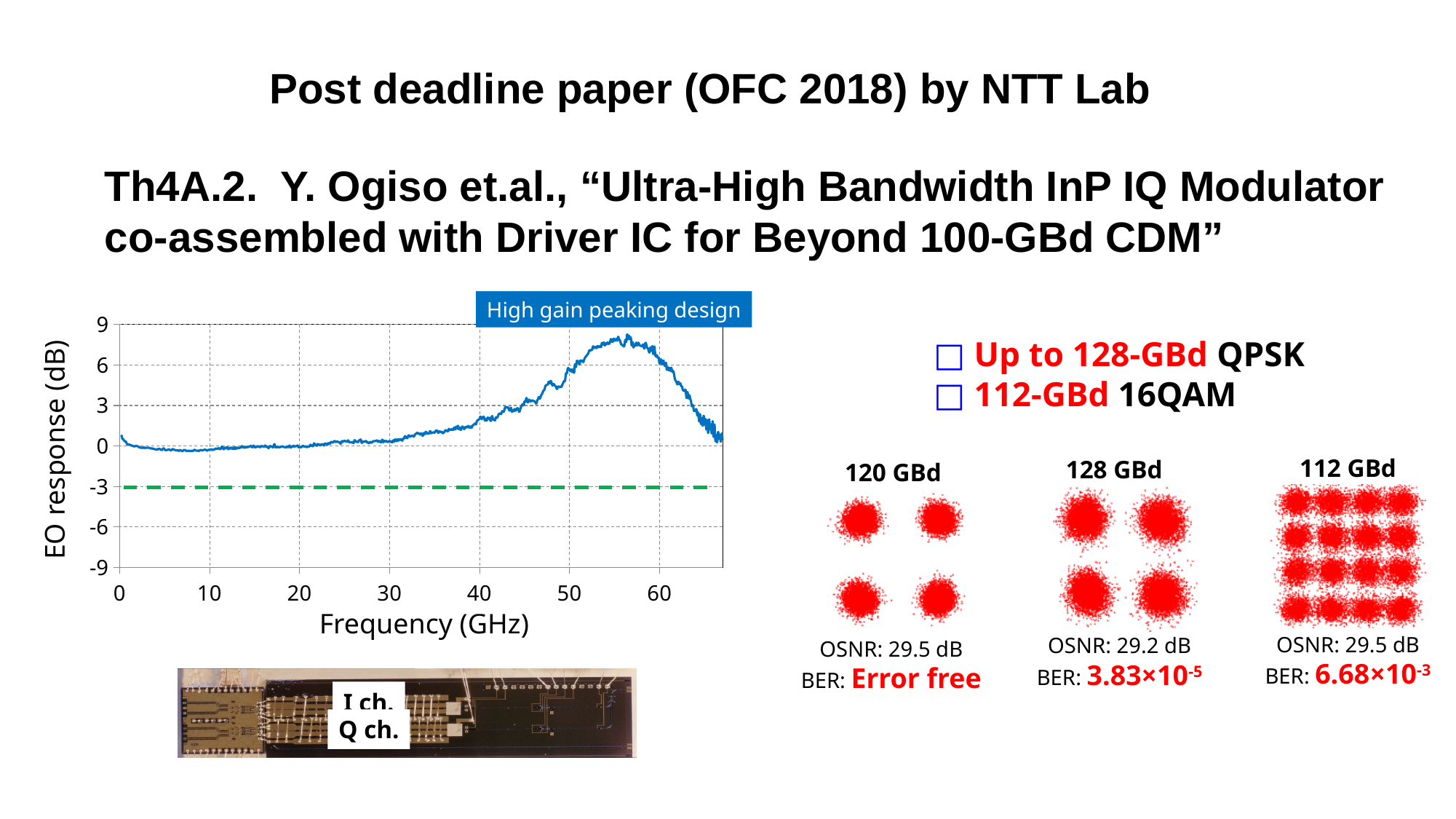
Is the EO response at 55 GHz greater or less than 6? greater Is the EO response at 40 GHz greater or less than 0? greater Between 40 GHz and 55 GHz, does the EO response rise or fall? rise What text appears in the blue box above the EO response chart? High gain peaking design What kind of chart is shown on the left of the slide? line chart Between 57 GHz and 67 GHz, does the EO response rise or fall? fall Is the EO response at 10 GHz greater or less than 3? less At what EO response level is the green dashed horizontal line drawn? -3 What is the highest tick value shown on the y-axis of the EO response chart? 9 What is the label of the y-axis of the EO response chart? EO response (dB)